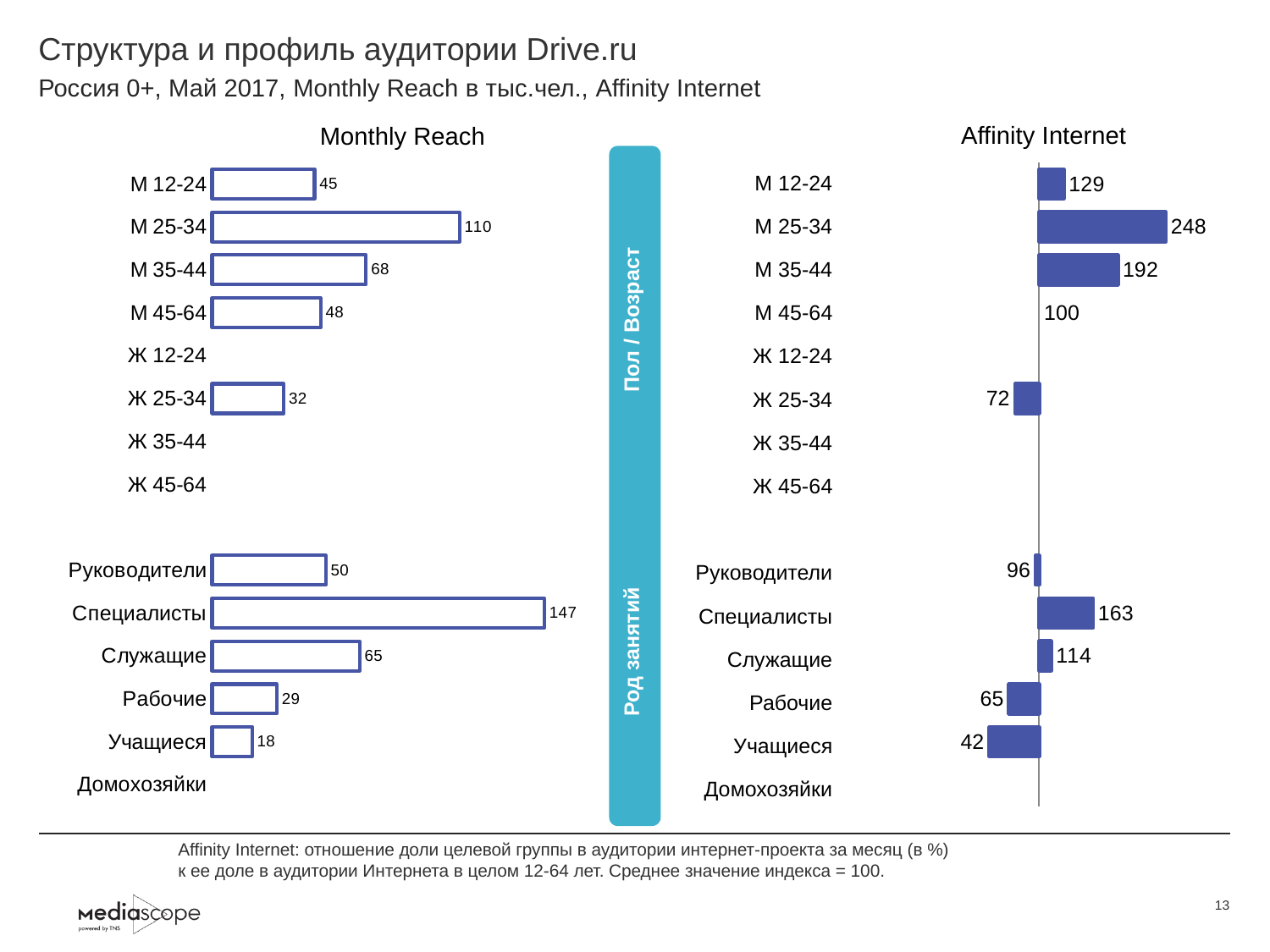
What type of chart is the Affinity Internet chart? Bar chart In the Monthly Reach chart, which is larger: the value for М 45-64 or the value for Ж 25-34? М 45-64 In the Affinity Internet chart, which is larger: the value for Служащие or the value for Руководители? Служащие In the Monthly Reach chart, which category has the highest value? Специалисты In the Affinity Internet chart, what is the value for Рабочие? 65 In the Monthly Reach chart, what is the difference between the values for М 25-34 and М 35-44? 42 In the Monthly Reach chart, which labelled category has the lowest value? Учащиеся In the Affinity Internet chart, which labelled category has the lowest value? Учащиеся In the Affinity Internet chart, which category has the highest value? М 25-34 In the Monthly Reach chart, what is the value for М 25-34? 110 In the Affinity Internet chart, what is the value for Специалисты? 163 In the Affinity Internet chart, what is the difference between the values for М 35-44 and М 12-24? 63